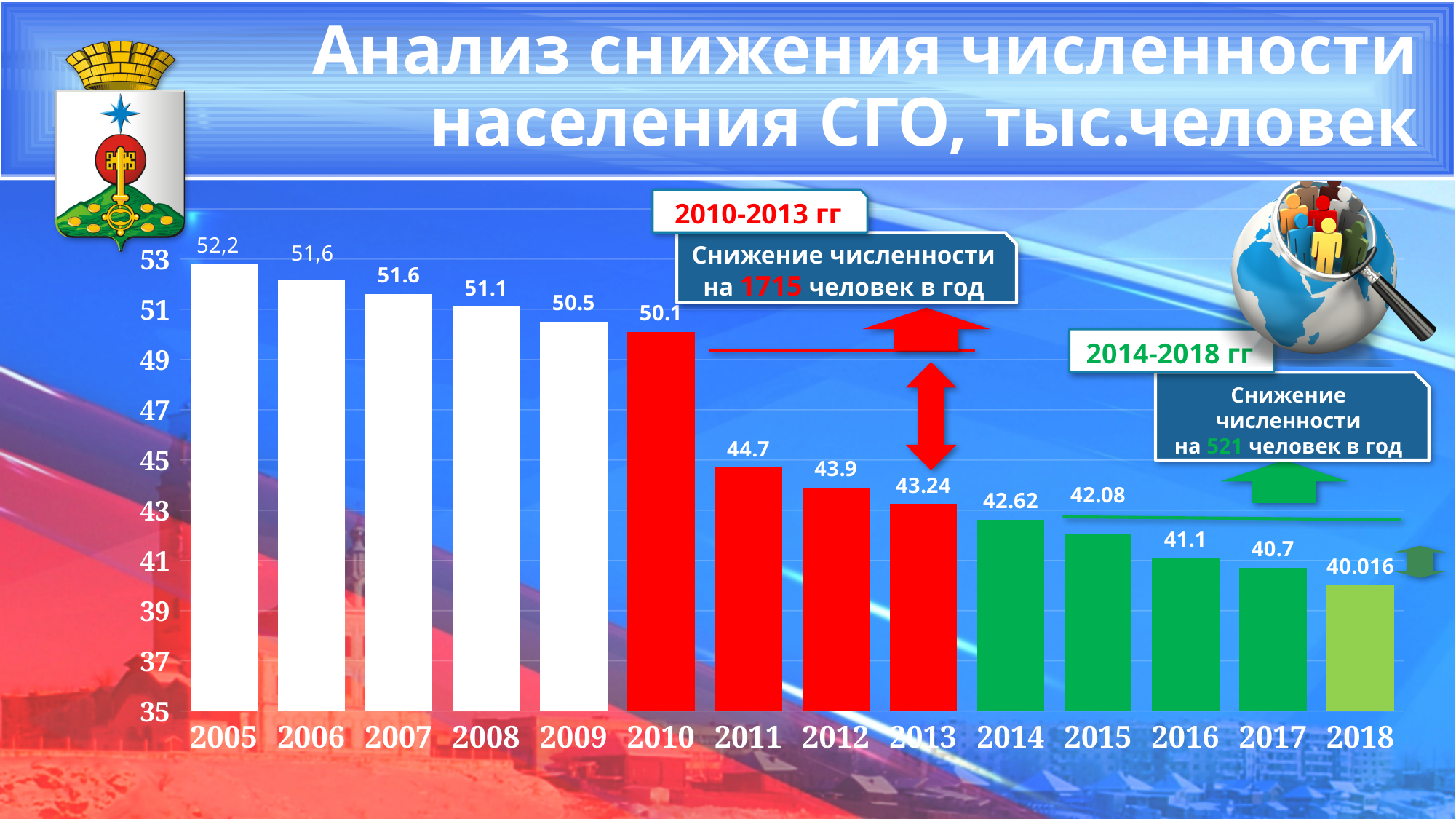
What is the population value shown for 2013? 43.24 What is the population value shown for 2018? 40.016 Do the values rise or fall from 2005 to 2018? Fall Is the value for 2014 greater or less than 41? greater How many years (bars) are shown on the chart? 14 Which year has a larger value, 2009 or 2014? 2009 Which year has the highest population value on the chart? 2005 Which year has the lowest population value on the chart? 2018 What is the difference between the values for 2010 and 2011? 5.4 What kind of chart is shown on the slide? Bar chart What is the population value shown for 2010? 50.1 What is the difference between the values for 2016 and 2017? 0.4